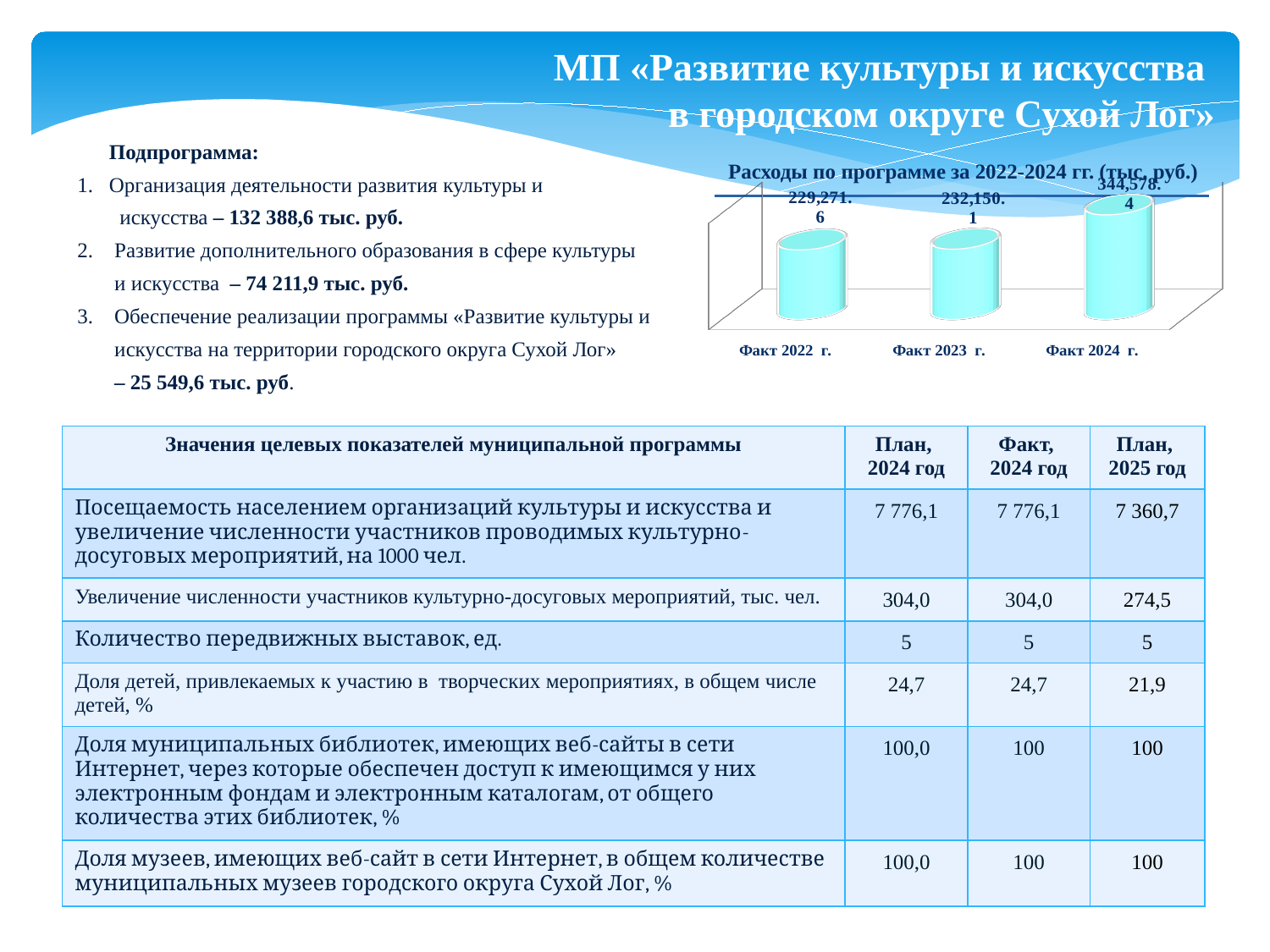
What is the value for Факт 2023 г. in the chart? 232,150.1 What is the difference between the values for Факт 2024 г. and Факт 2023 г.? 112,428.3 What is the value for Факт 2024 г. in the chart? 344,578.4 Which category has the lowest value in the chart? Факт 2022 г. What is the title of the chart? Расходы по программе за 2022-2024 гг. (тыс. руб.) Which is larger, the value for Факт 2024 г. or the value for Факт 2022 г.? Факт 2024 г. What is the value for Факт 2022 г. in the chart? 229,271.6 What is the difference between the values for Факт 2023 г. and Факт 2022 г.? 2,878.5 Which category has the highest value in the chart? Факт 2024 г. Do the values rise or fall from Факт 2022 г. to Факт 2024 г.? Rise How many categories are shown in the chart? 3 What kind of chart is shown on the slide? Bar chart